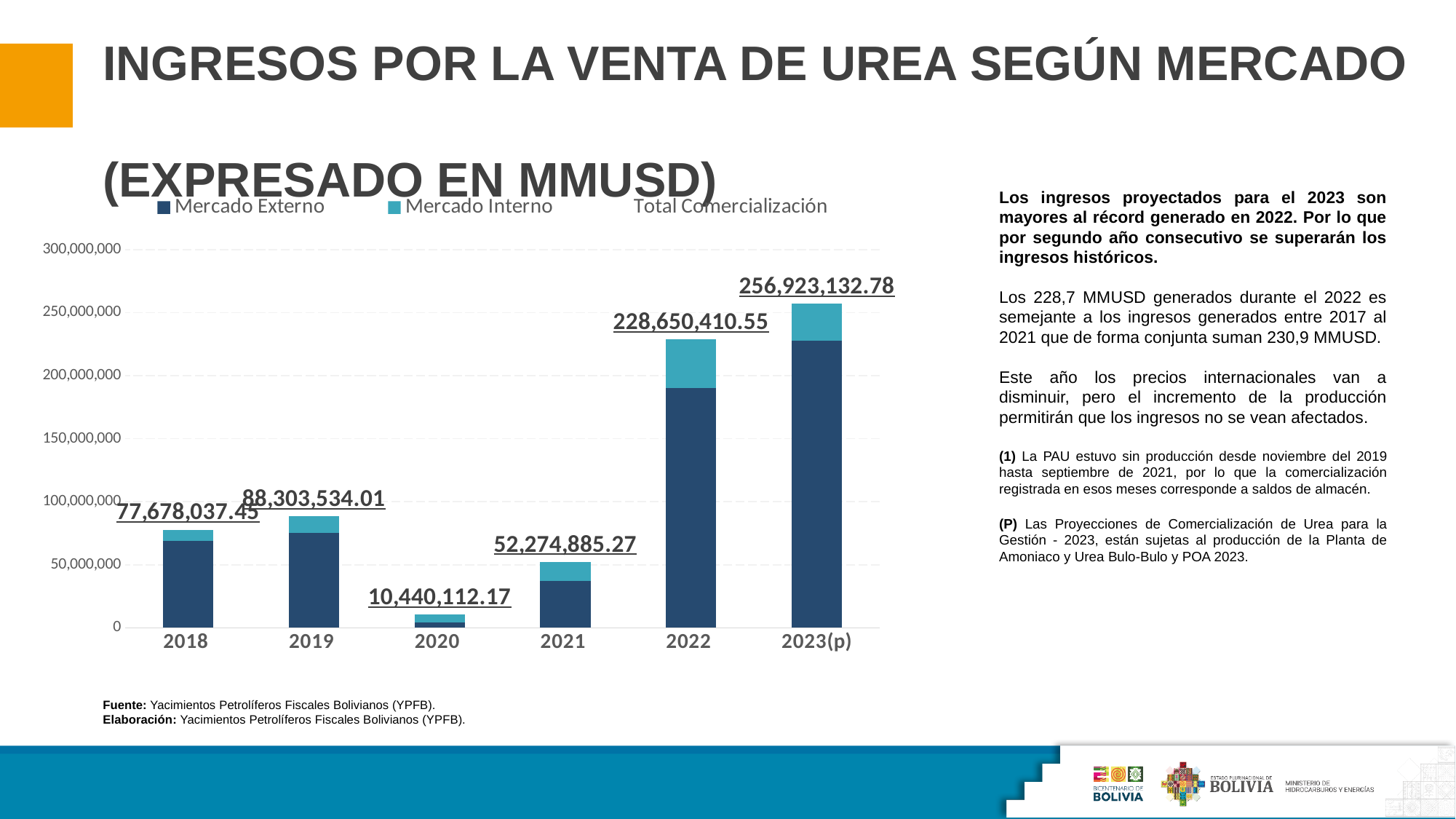
Which year has the highest total comercialización? 2023(p) What is the difference between the total comercialización for 2023(p) and 2022? 28,272,722.23 What is the total comercialización value labelled for 2023(p)? 256,923,132.78 How many years are shown on the x axis of the chart? 6 What kind of chart is shown on the slide? Stacked bar chart What is the total comercialización value labelled for 2020? 10,440,112.17 How many entries does the chart legend list? 3 What is the total comercialización value labelled for 2022? 228,650,410.55 Which year has the lowest total comercialización? 2020 Is the Mercado Externo value for 2022 greater or less than 150,000,000? greater Which year has a larger total comercialización, 2019 or 2021? 2019 What is the difference between the total comercialización for 2019 and 2018? 10,625,496.56